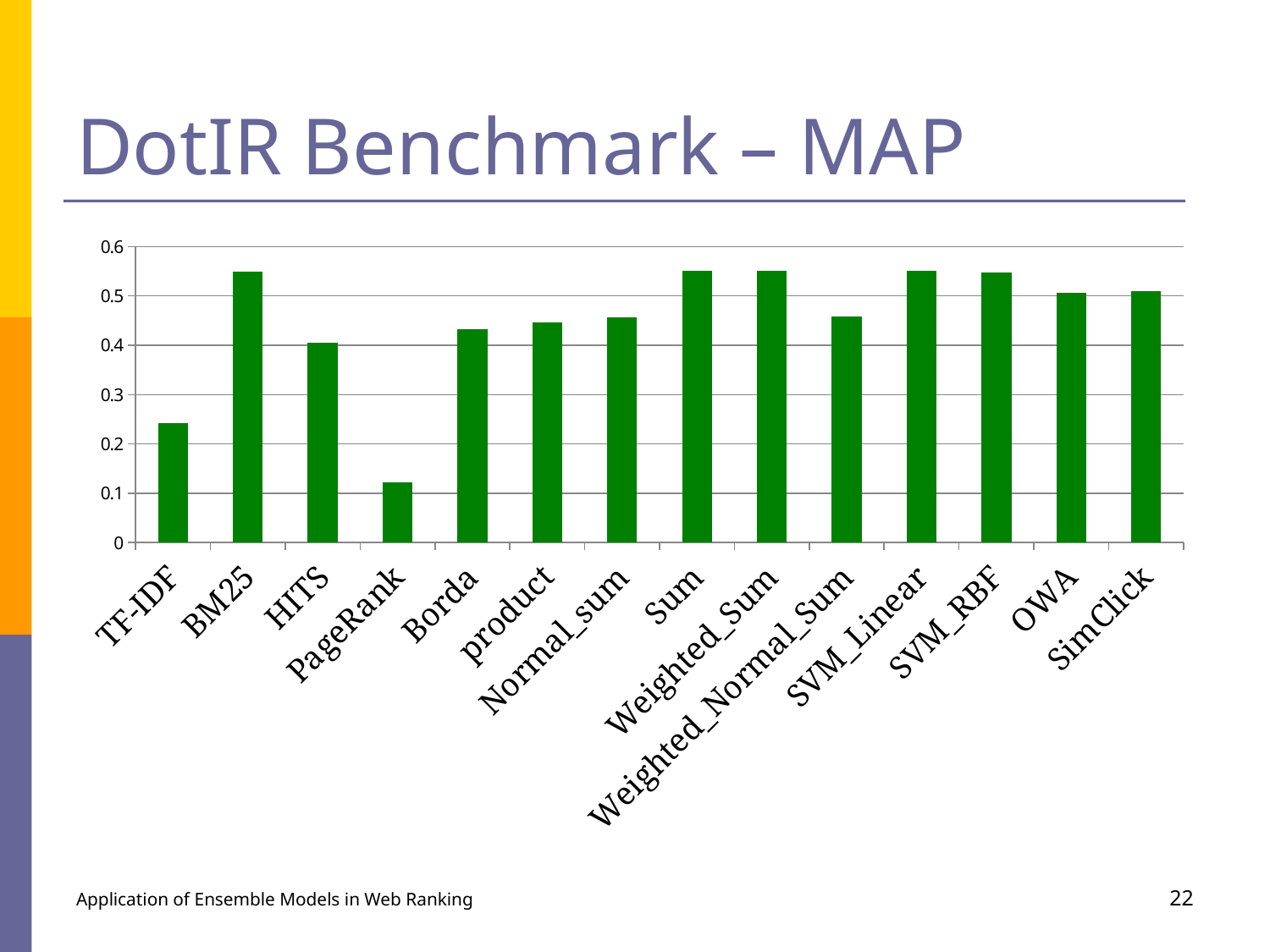
Which has a larger value, BM25 or TF-IDF? BM25 Is the value for Weighted_Normal_Sum greater or less than 0.5? less Is the value for Borda greater or less than 0.4? greater Is the value for TF-IDF greater or less than 0.3? less Which has a larger value, Borda or Sum? Sum How many categories are plotted on the x axis of the chart? 14 What colour are the bars in the chart? green Which has a larger value, HITS or PageRank? HITS What kind of chart is shown on the slide? bar chart Which category has the lowest value in the chart? PageRank